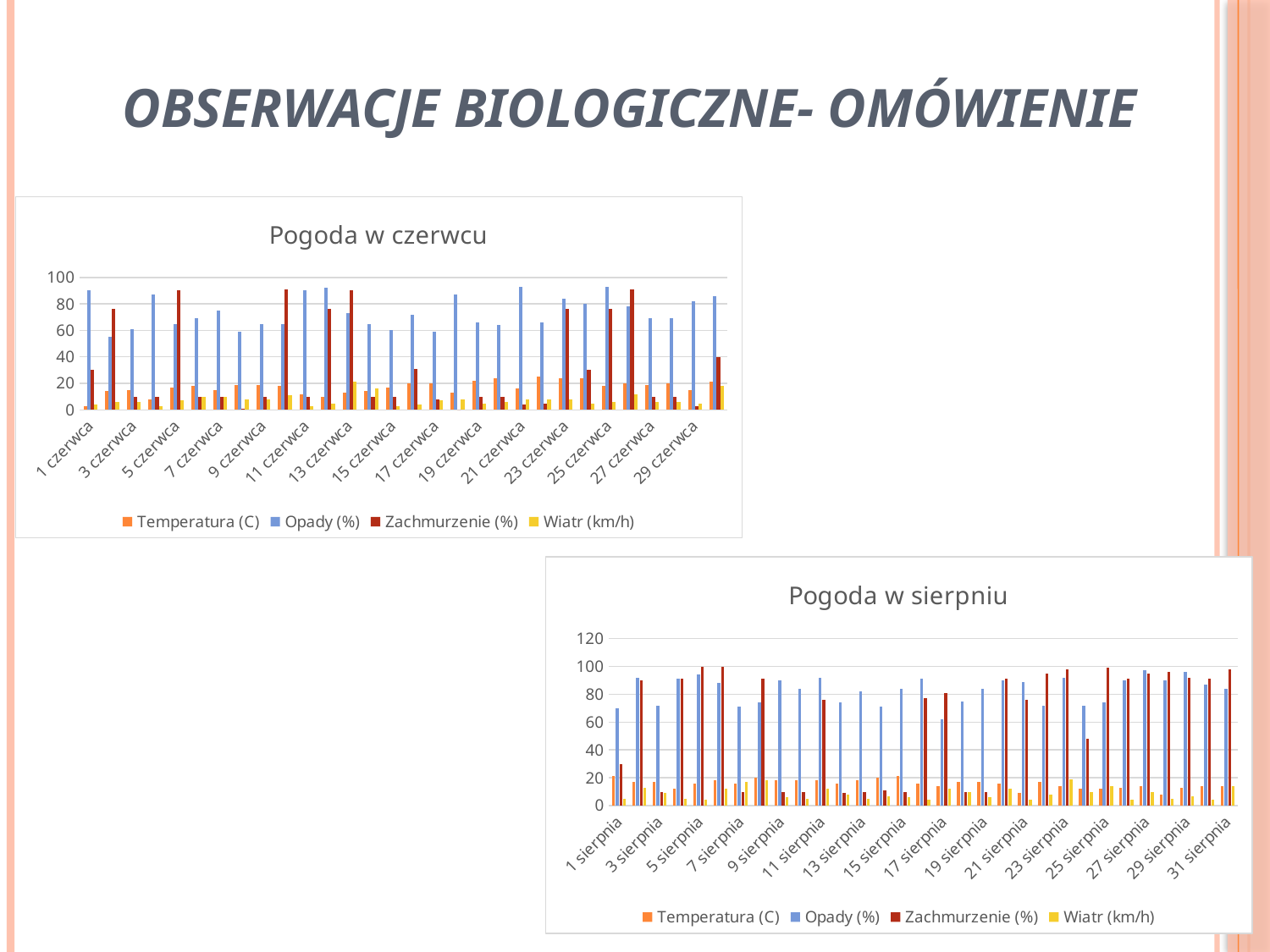
What kind of chart is "Pogoda w czerwcu"? bar chart In "Pogoda w czerwcu", is the Opady (%) value for 1 czerwca greater or less than 80? greater In "Pogoda w sierpniu", is the Zachmurzenie (%) value for 1 sierpnia greater or less than 40? less What is the title of the lower-right chart on the slide? Pogoda w sierpniu In "Pogoda w sierpniu", is the Opady (%) value for 1 sierpnia greater or less than 60? greater What are the series names in the legend of "Pogoda w czerwcu"? Temperatura (C), Opady (%), Zachmurzenie (%), Wiatr (km/h) How many series does the legend of "Pogoda w sierpniu" list? 4 In "Pogoda w sierpniu", which is larger for 25 sierpnia, Opady (%) or Zachmurzenie (%)? Zachmurzenie (%) In "Pogoda w czerwcu", which is larger for 1 czerwca, Opady (%) or Zachmurzenie (%)? Opady (%)